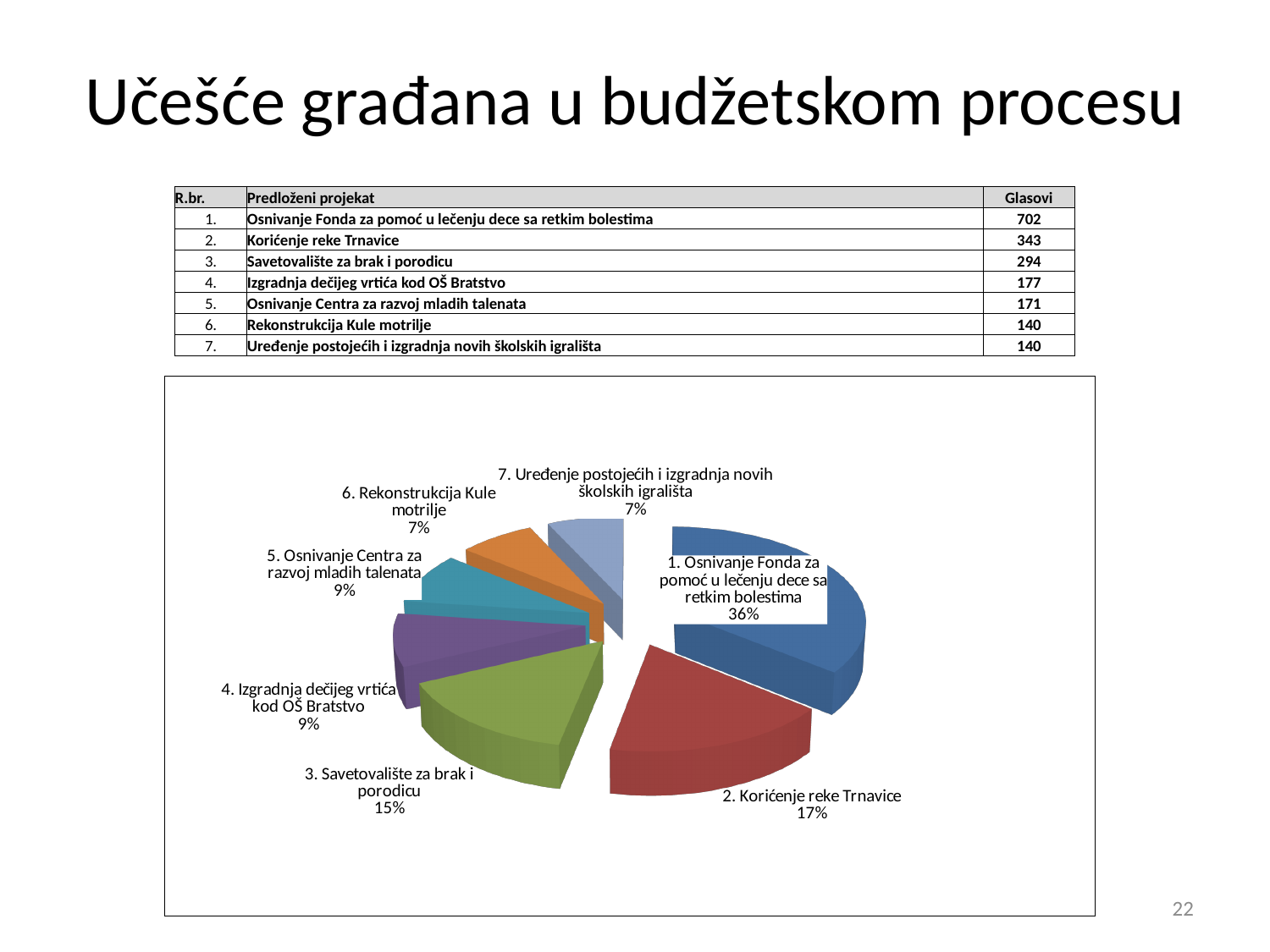
Which is larger in the pie chart: the share for "2. Korićenje reke Trnavice" or the share for "3. Savetovalište za brak i porodicu"? 2. Korićenje reke Trnavice Which slice of the pie chart is the largest? 1. Osnivanje Fonda za pomoć u lečenju dece sa retkim bolestima What share of the pie does "1. Osnivanje Fonda za pomoć u lečenju dece sa retkim bolestima" have? 36% What share of the pie does "4. Izgradnja dečijeg vrtića kod OŠ Bratstvo" have? 9% What share of the pie does "6. Rekonstrukcija Kule motrilje" have? 7% What is the difference in percentage points between the share for "3. Savetovalište za brak i porodicu" and the share for "5. Osnivanje Centra za razvoj mladih talenata"? 6 What kind of chart is shown on the slide? pie chart What colour is the slice for "1. Osnivanje Fonda za pomoć u lečenju dece sa retkim bolestima" in the pie chart? blue How many slices does the pie chart have? 7 What is the difference in percentage points between the share for "1. Osnivanje Fonda za pomoć u lečenju dece sa retkim bolestima" and the share for "2. Korićenje reke Trnavice"? 19